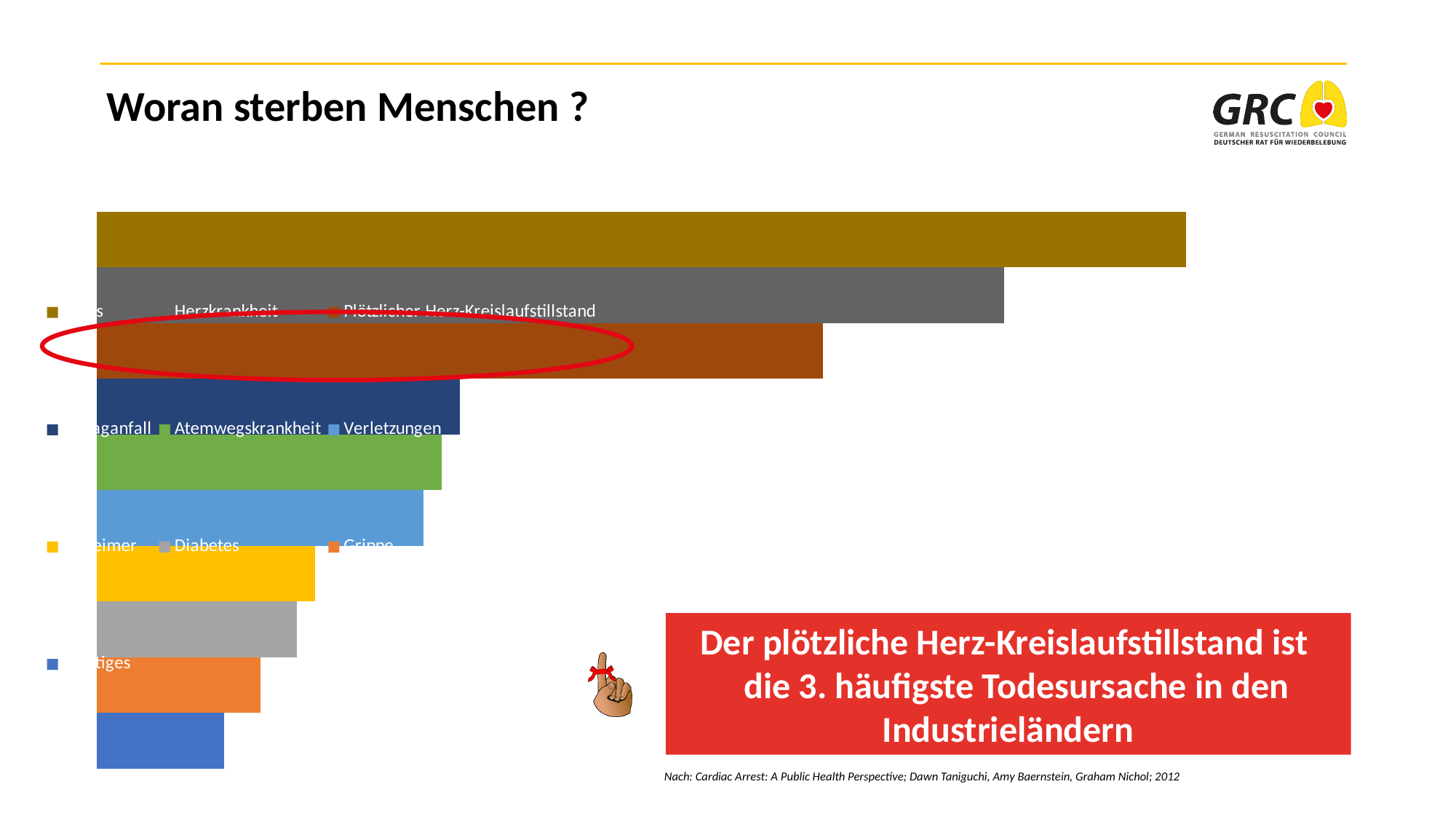
How many bars does the chart contain? 10 Which is larger, the value for Verletzungen or the value for Diabetes? Verletzungen Which is larger, the value for Herzkrankheit or the value for Plötzlicher Herz-Kreislaufstillstand? Herzkrankheit Which is larger, the value for Herzkrankheit or the value for Diabetes? Herzkrankheit What kind of chart is shown on the slide? bar chart What is the title of the slide containing the chart? Woran sterben Menschen ? Which bar is circled in red on the chart? Plötzlicher Herz-Kreislaufstillstand